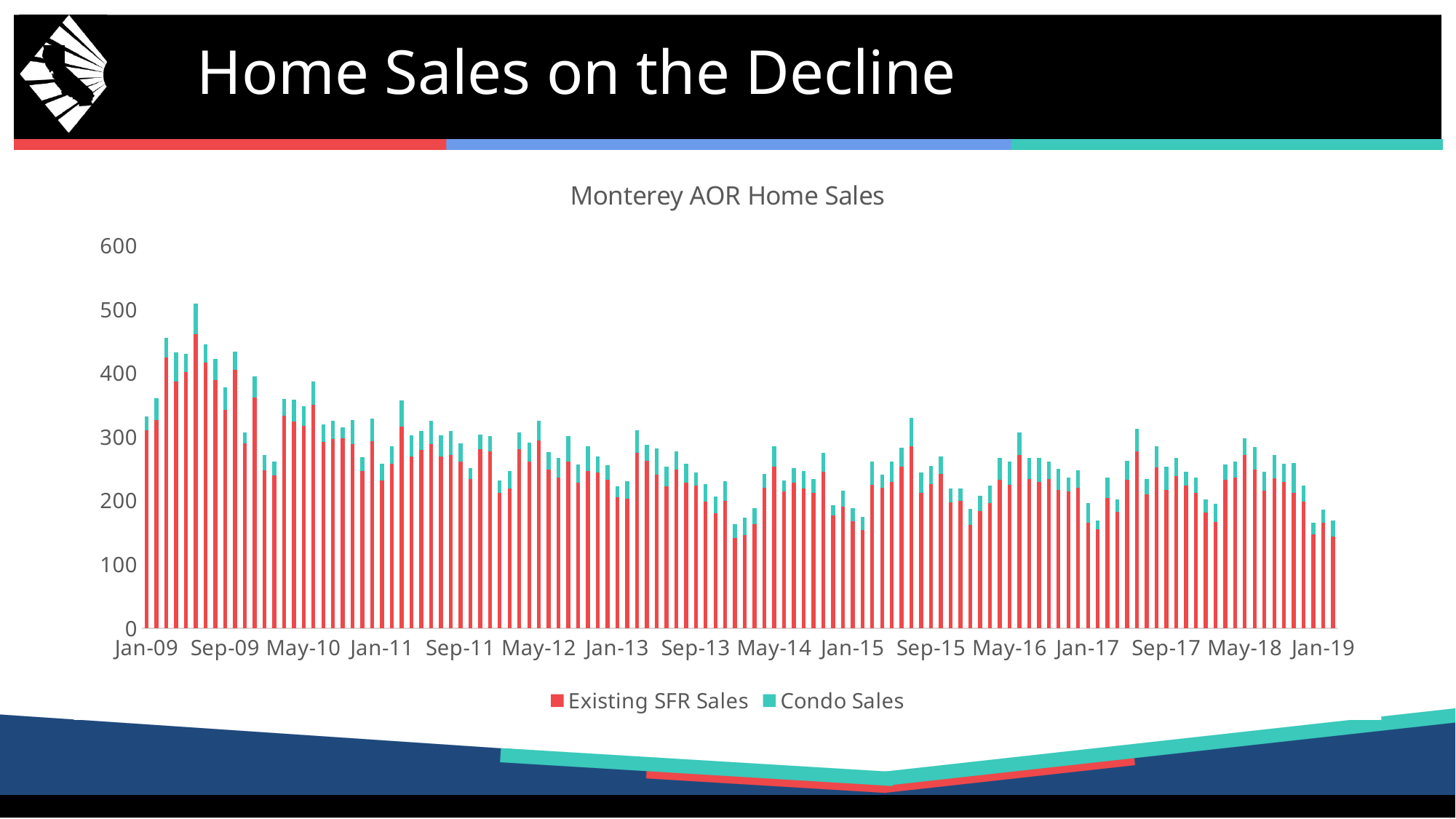
In Jan-09, which series contributes more to the bar, Existing SFR Sales or Condo Sales? Existing SFR Sales What kind of chart is shown on the slide? Stacked bar chart Is the total bar for Jan-09 greater or less than 300? greater Is the total bar for Jan-17 greater or less than 300? less Is the total bar for Jan-19 greater or less than 200? less What is the title of the chart? Monterey AOR Home Sales Which is larger, the total bar for Jan-09 or the total bar for Jan-19? Jan-09 Which series is shown in red in the chart? Existing SFR Sales Overall, do total home sales rise or fall from Jan-09 to Jan-19? Fall How many series does the legend list? 2